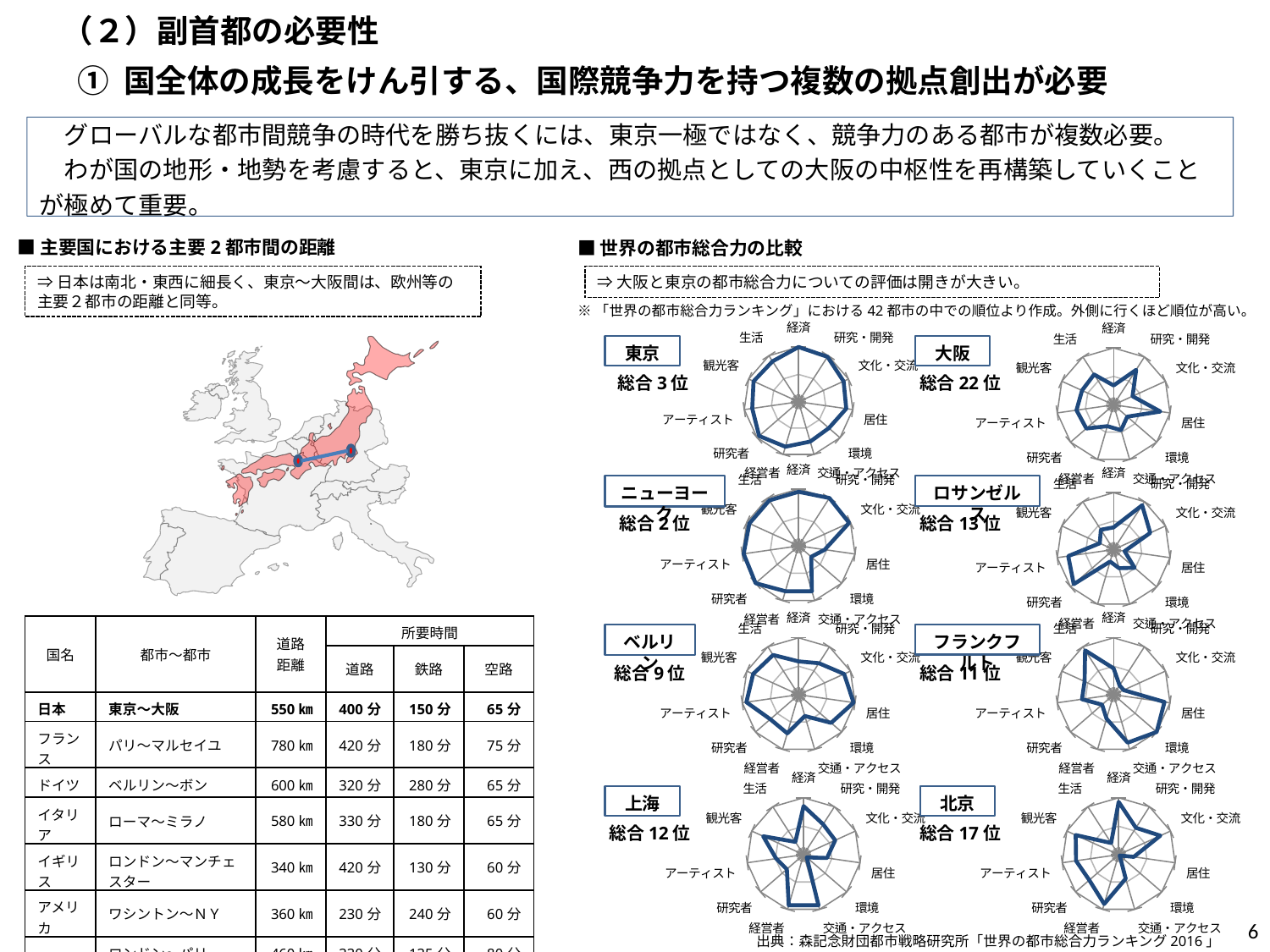
In the 「世界の都市総合力の比較」 section, which has the better overall rank, ベルリン or フランクフルト? ベルリン In the 「世界の都市総合力の比較」 section, what overall rank (総合) is printed next to the 上海 radar chart? 総合 12 位 How many radar charts are shown in the 「世界の都市総合力の比較」 section? 8 In the 「世界の都市総合力の比較」 section, what overall rank (総合) is printed next to the 北京 radar chart? 総合 17 位 In the 「世界の都市総合力の比較」 section, what overall rank (総合) is printed next to the ニューヨーク radar chart? 総合 2 位 In the 「世界の都市総合力の比較」 section, which city's radar chart is labelled with the best (lowest-numbered) overall rank? ニューヨーク In the 「世界の都市総合力の比較」 section, what overall rank (総合) is printed next to the 大阪 radar chart? 総合 22 位 What kind of chart is used in the 「世界の都市総合力の比較」 section to show each city's profile? radar chart According to the note above the radar charts, does a point further toward the outside of the chart indicate a higher or lower rank? higher rank In the 「世界の都市総合力の比較」 section, which city's radar chart is labelled with the worst (highest-numbered) overall rank? 大阪 In the 「世界の都市総合力の比較」 section, what overall rank (総合) is printed next to the 東京 radar chart? 総合 3 位 In the 「世界の都市総合力の比較」 section, how many rank positions separate 東京 (総合 3 位) and 大阪 (総合 22 位)? 19